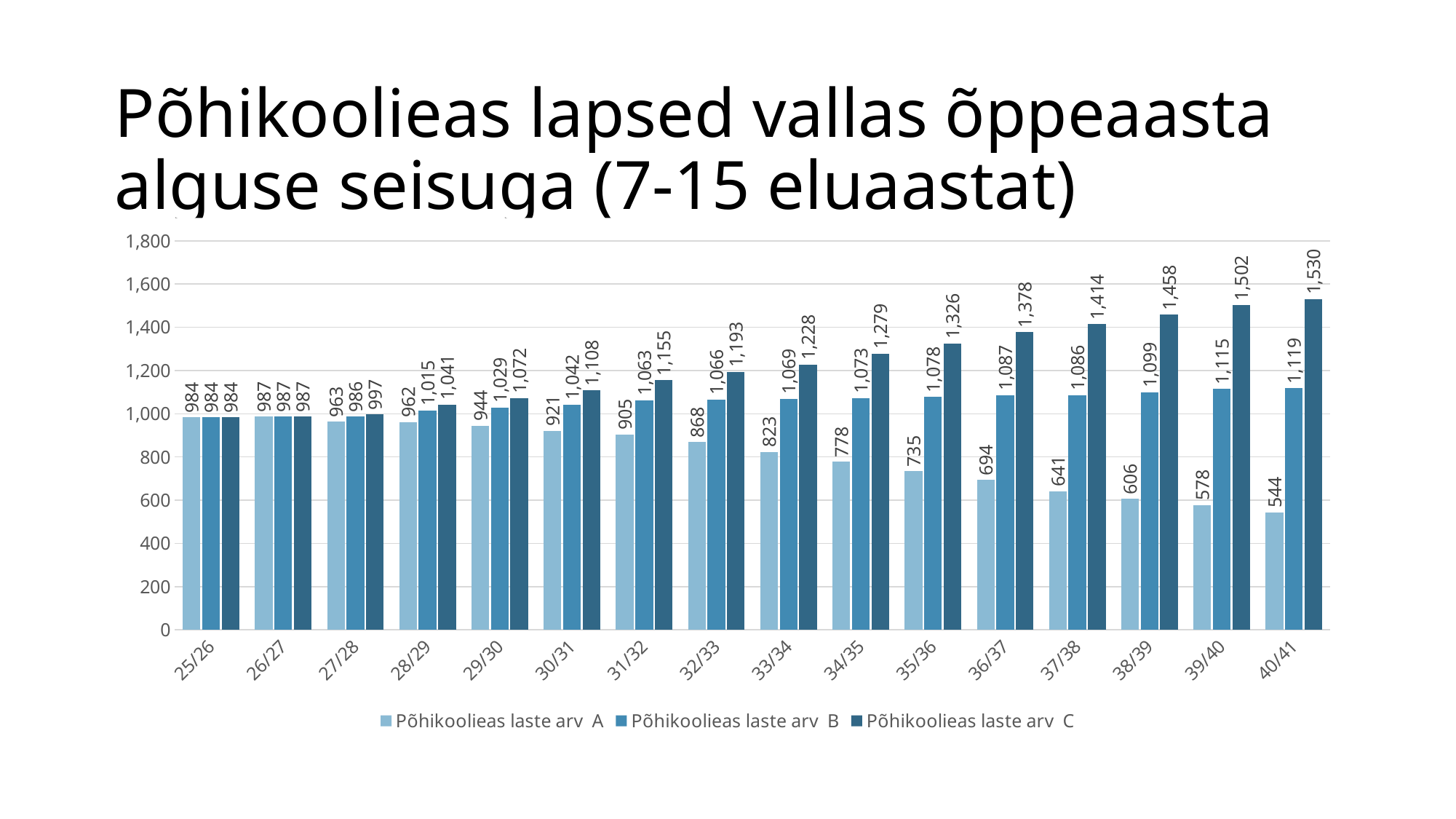
What is the difference between Põhikoolieas laste arv C and Põhikoolieas laste arv A for 40/41? 986 How many school years (categories) are shown on the x axis? 16 Which school year has the lowest value for Põhikoolieas laste arv A? 40/41 What is the value of Põhikoolieas laste arv C for 40/41? 1,530 Which school year has the highest value for Põhikoolieas laste arv C? 40/41 What is the title of the chart? Põhikoolieas lapsed vallas õppeaasta alguse seisuga (7-15 eluaastat) What is the value of Põhikoolieas laste arv B for 31/32? 1,063 What is the value of Põhikoolieas laste arv A for 33/34? 823 How many series does the legend list? 3 Does the value of Põhikoolieas laste arv A rise or fall from 27/28 to 40/41? fall What kind of chart is shown on the slide? bar chart Which is larger for 36/37: Põhikoolieas laste arv B or Põhikoolieas laste arv A? Põhikoolieas laste arv B